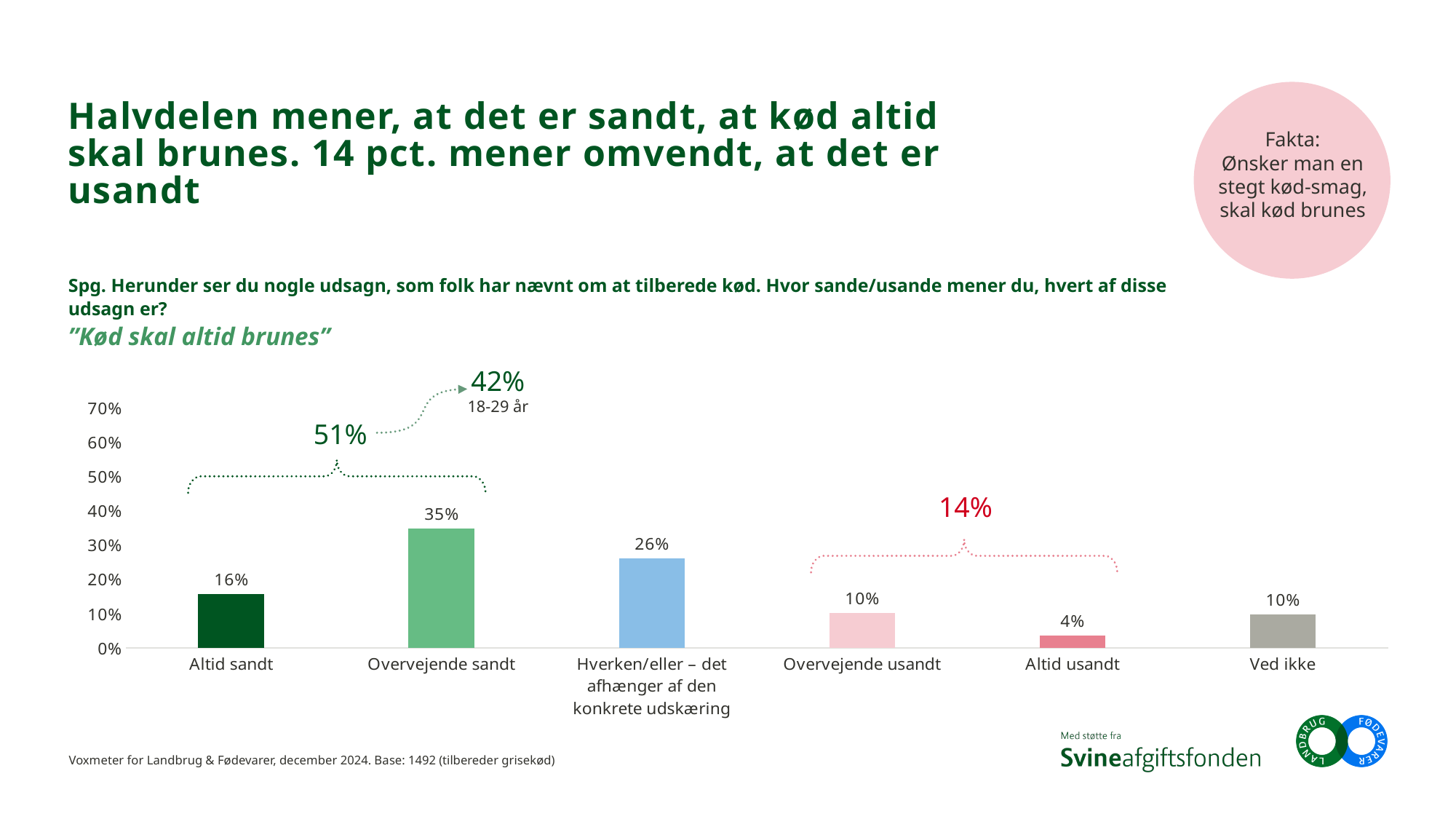
Which category has the lowest value in the chart? Altid usandt Which category has the highest value in the chart? Overvejende sandt What is the value shown for "Overvejende sandt"? 35% What combined percentage does the bracket over "Altid sandt" and "Overvejende sandt" show? 51% What is the value for "Altid usandt"? 4% How many categories are shown on the x axis of the chart? 6 What percentage is shown for the 18-29 år group in the annotation? 42% What percentage of respondents answered "Altid sandt"? 16% What percentage is shown for "Hverken/eller – det afhænger af den konkrete udskæring"? 26% What is the difference between the values for "Overvejende sandt" and "Altid sandt"? 19% What kind of chart is shown on the slide? Bar chart Which is larger, the value for "Hverken/eller – det afhænger af den konkrete udskæring" or the value for "Altid sandt"? Hverken/eller – det afhænger af den konkrete udskæring